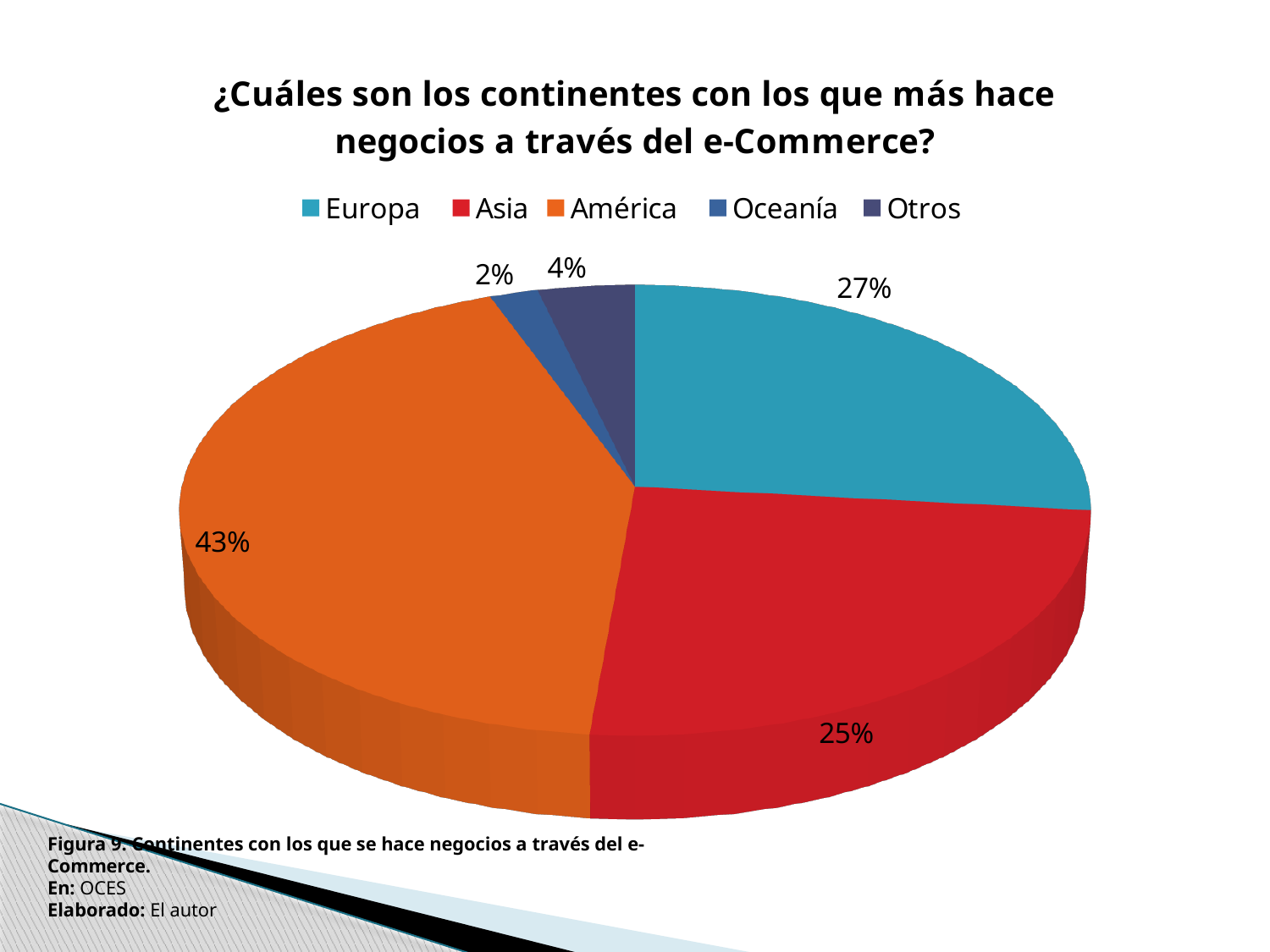
What share of the pie does Europa have? 27% Which continent has the largest share of the pie? América Which category has the smallest share of the pie? Oceanía What share of the pie does Otros have? 4% Which has a larger share, Europa or Asia? Europa What colour is the slice for América? Orange What is the difference in percentage points between América and Asia? 18 How many slices does the pie chart have? 5 What share of the pie does Oceanía have? 2% What kind of chart is shown on the slide? Pie chart What share of the pie does Asia have? 25% What share of the pie does América have? 43%